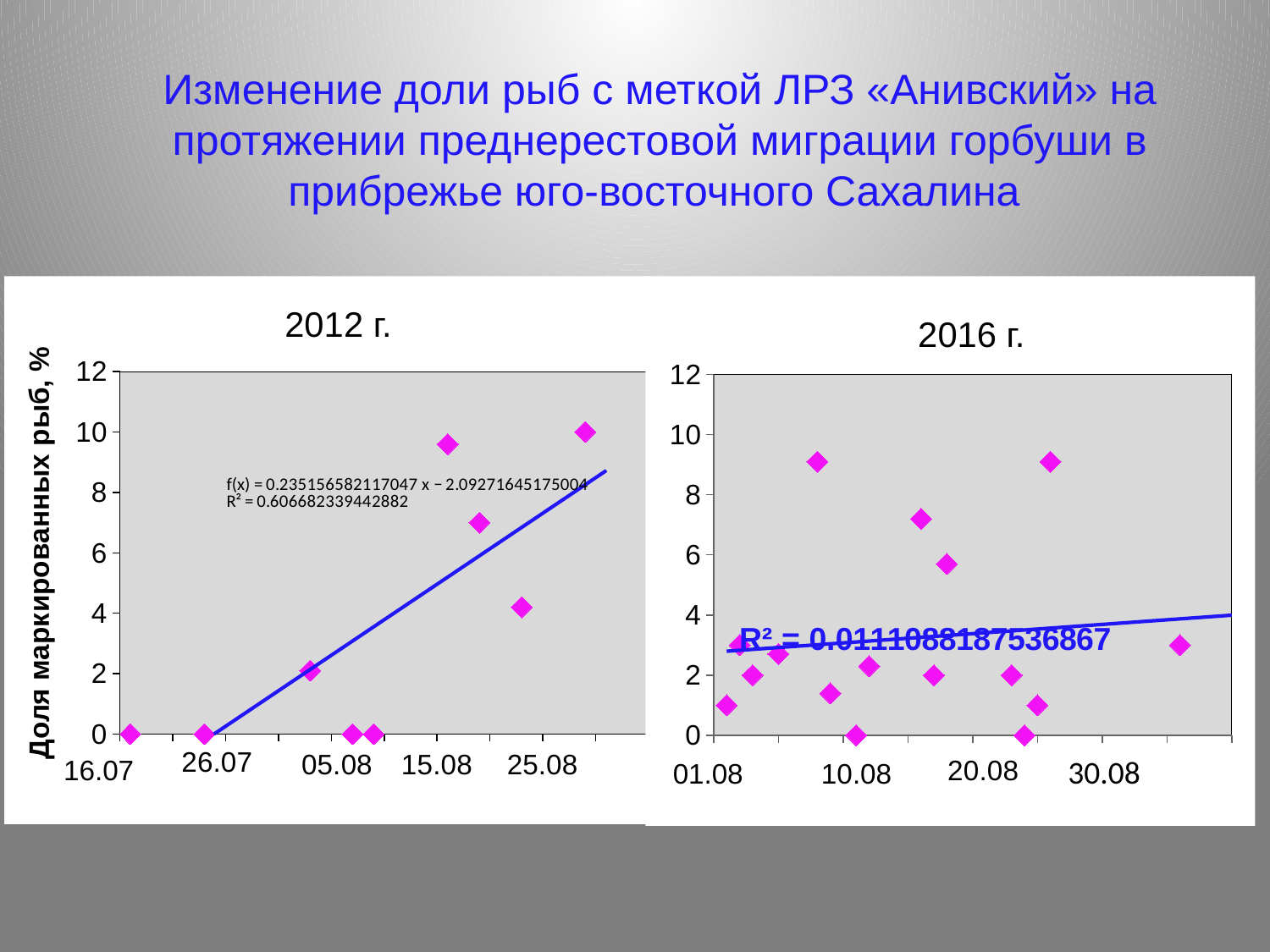
What R² value is printed on the 2012 г. chart? 0.606682339442882 Which chart has the larger R² value, 2012 г. or 2016 г.? 2012 г. What kind of chart is the 2012 г. chart? scatter chart What R² value is printed on the 2016 г. chart? 0.0111088187536867 What is the y-axis label on the 2012 г. chart? Доля маркированных рыб, % What is the maximum value shown on the y axis of the 2016 г. chart? 12 What trendline equation is printed on the 2012 г. chart? f(x) = 0.235156582117047 x − 2.09271645175004 In the 2012 г. chart, is the highest plotted point greater or less than 8? greater In the 2016 г. chart, is the highest plotted point greater or less than 8? greater In the 2012 г. chart, does the trendline rise or fall along the x axis? rise